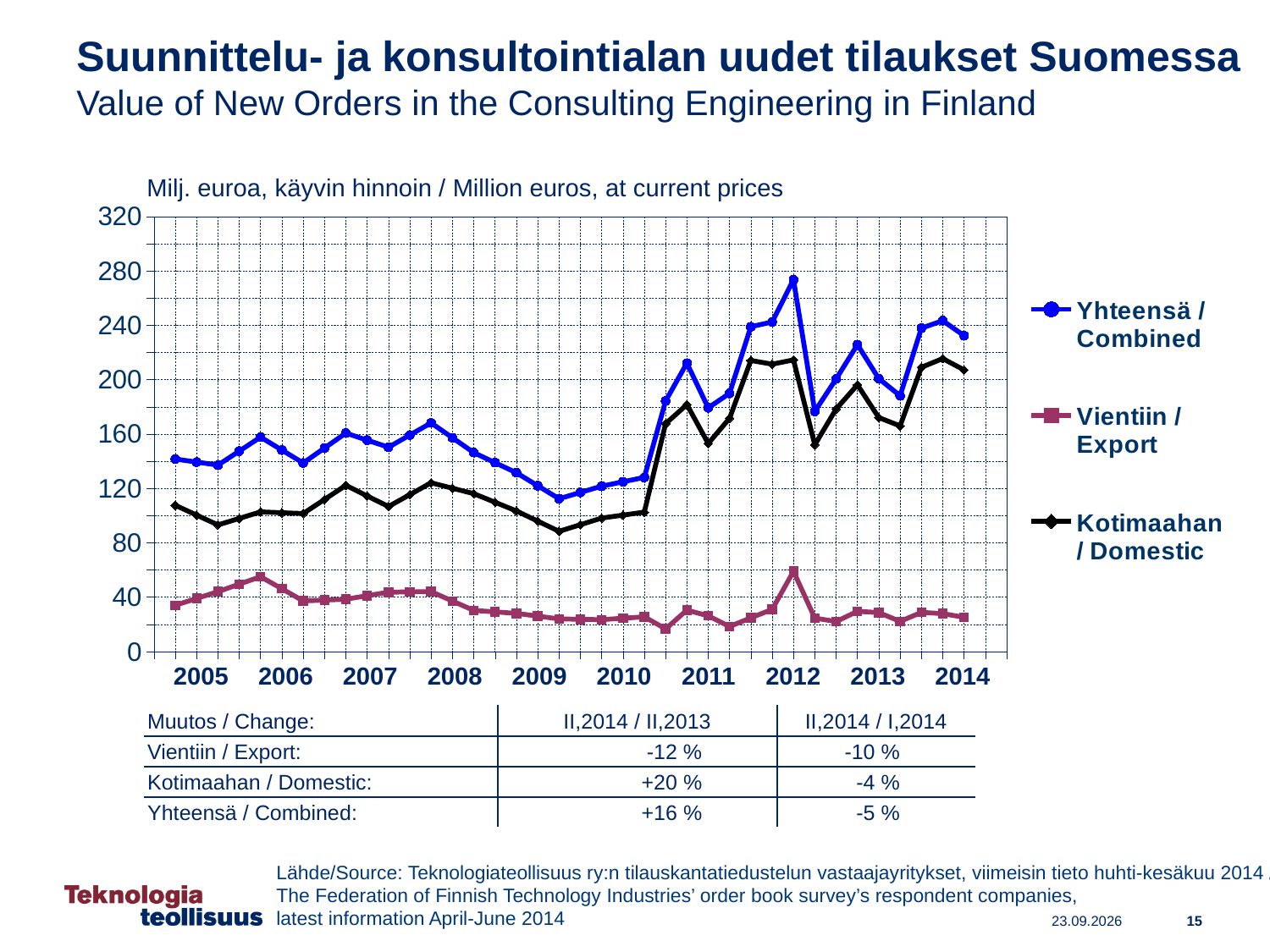
What kind of chart is shown on the slide? line chart How many years are labelled on the x axis? 10 How many series does the chart legend list? 3 Is the peak value of the Vientiin / Export series in 2012 greater or less than 40? greater Is the value of the Yhteensä / Combined series at the start of 2005 greater or less than 120? greater Which series is larger in 2013, Kotimaahan / Domestic or Vientiin / Export? Kotimaahan / Domestic Is the lowest value of the Kotimaahan / Domestic series in 2009 greater or less than 120? less Which series has the lowest values throughout the chart? Vientiin / Export Does the Yhteensä / Combined series generally rise or fall between 2009 and 2012? rise Which series has the highest values throughout the chart? Yhteensä / Combined What unit is stated above the chart for the plotted values? Milj. euroa, käyvin hinnoin / Million euros, at current prices